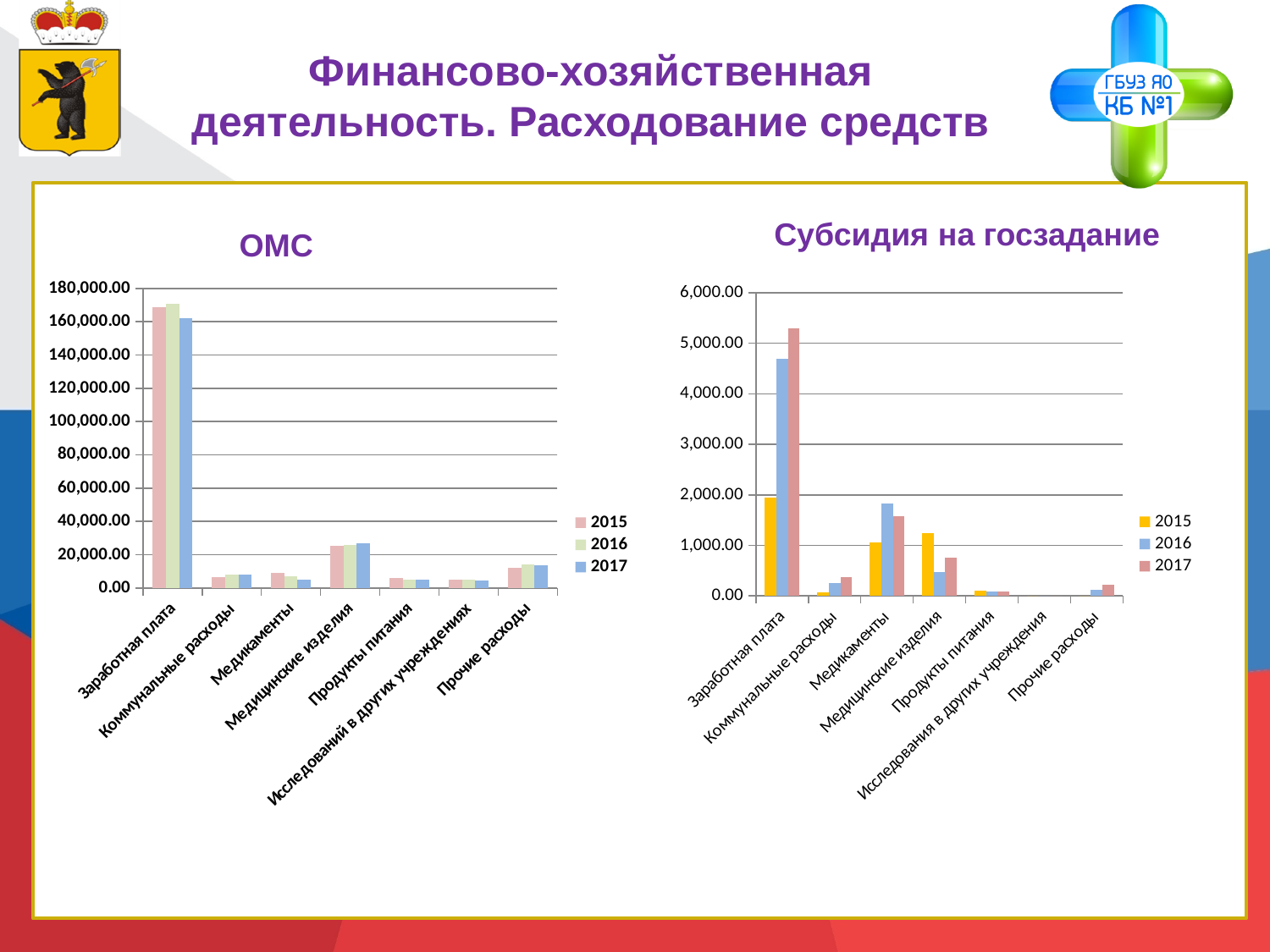
In the Субсидия на госзадание chart, do the values for Заработная плата rise or fall from 2015 to 2017? rise In the ОМС chart, is the 2017 value for Медицинские изделия greater or less than 20,000.00? greater In the Субсидия на госзадание chart, is the 2017 value for Заработная плата greater or less than 5,000.00? greater What kind of chart is the ОМС chart? bar chart In the ОМС chart, which category has the highest values? Заработная плата How many categories are shown on the x axis of the ОМС chart? 7 In the ОМС chart, is the 2015 value for Коммунальные расходы greater or less than 20,000.00? less How many series does the legend of the Субсидия на госзадание chart list? 3 In the Субсидия на госзадание chart, which is larger for Заработная плата: the 2016 value or the 2017 value? 2017 In the Субсидия на госзадание chart, which category has the highest bar? Заработная плата